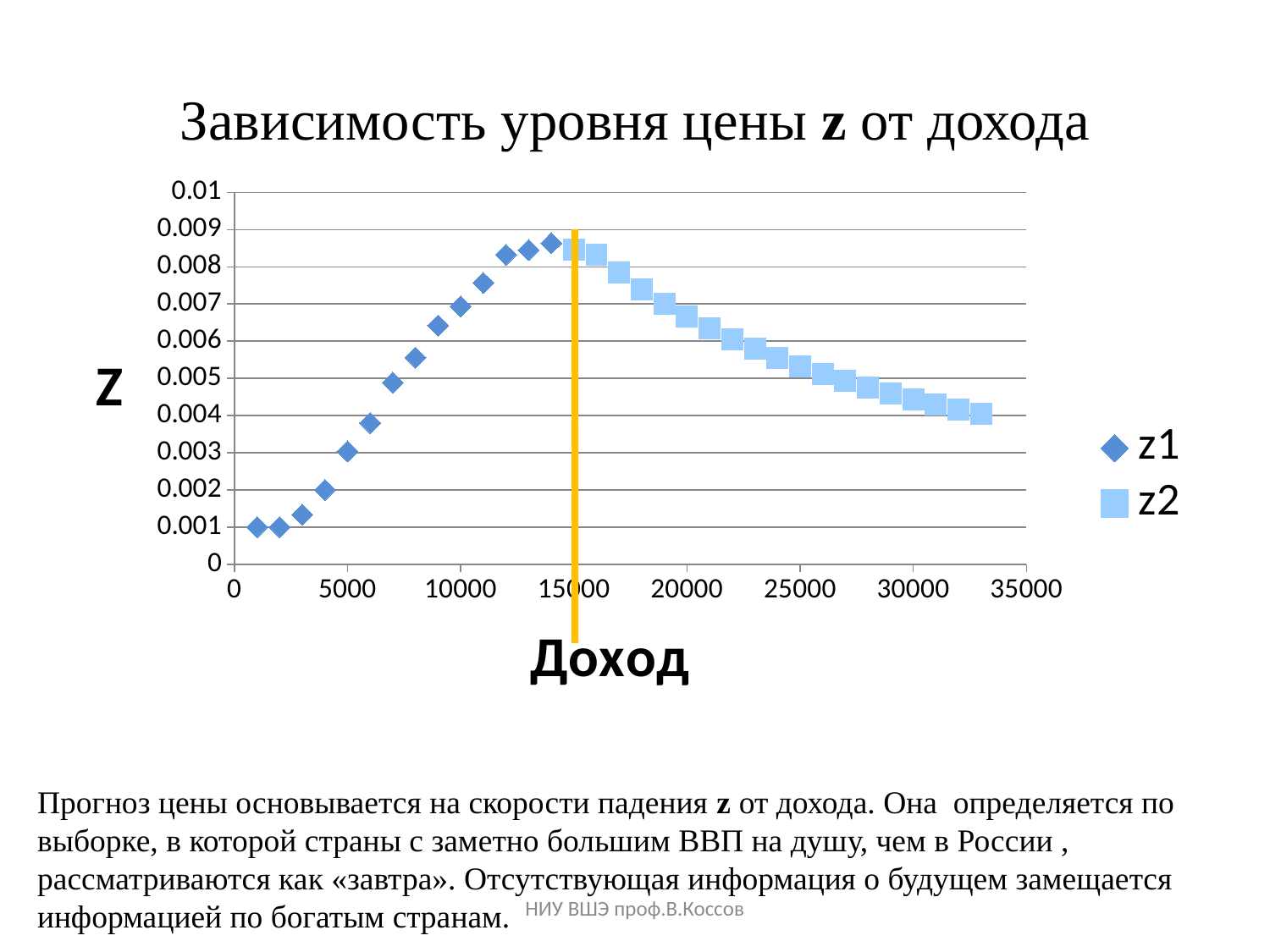
What kind of chart is shown on the slide? scatter chart Is the z2 value at an income of 20000 greater or less than 0.006? greater How many series does the legend list? 2 Which is larger: the z1 value at an income of 5000 or the z2 value at an income of 20000? z2 at 20000 What is the title of the chart? Зависимость уровня цены z от дохода Is the z2 value at an income of 30000 greater or less than 0.005? less What are the two series named in the legend? z1 and z2 Is the z1 value at an income of 14000 greater or less than 0.008? greater Which is larger: the z1 value at an income of 10000 or the z2 value at an income of 30000? z1 at 10000 Do the z2 values rise or fall as income (Доход) increases? fall Do the z1 values rise or fall as income (Доход) increases? rise